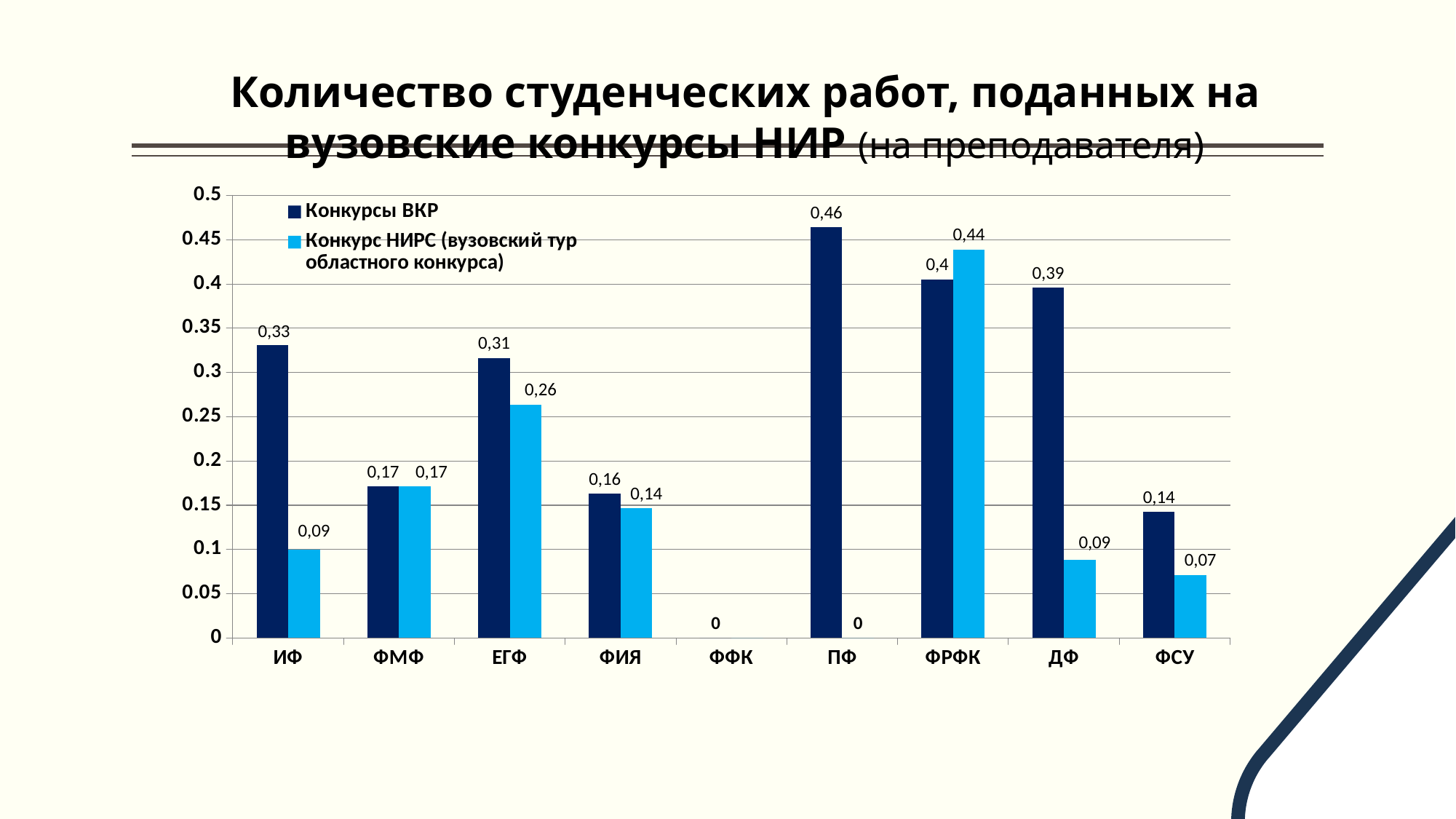
How many series does the legend list? 2 What is the value of Конкурсы ВКР for ПФ? 0,46 Which category has the highest value for Конкурс НИРС (вузовский тур областного конкурса)? ФРФК Is the Конкурсы ВКР value for ЕГФ greater or less than 0.3? greater How many categories are shown on the x axis? 9 What is the value of Конкурс НИРС (вузовский тур областного конкурса) for ЕГФ? 0,26 What is the value of Конкурс НИРС (вузовский тур областного конкурса) for ФСУ? 0,07 For ФРФК, which series has the larger value: Конкурсы ВКР or Конкурс НИРС (вузовский тур областного конкурса)? Конкурс НИРС (вузовский тур областного конкурса) What is the difference between the Конкурсы ВКР and Конкурс НИРС values for ИФ? 0,24 What kind of chart is shown on the slide? bar chart Which category has the highest value for Конкурсы ВКР? ПФ What is the value of Конкурсы ВКР for ДФ? 0,39